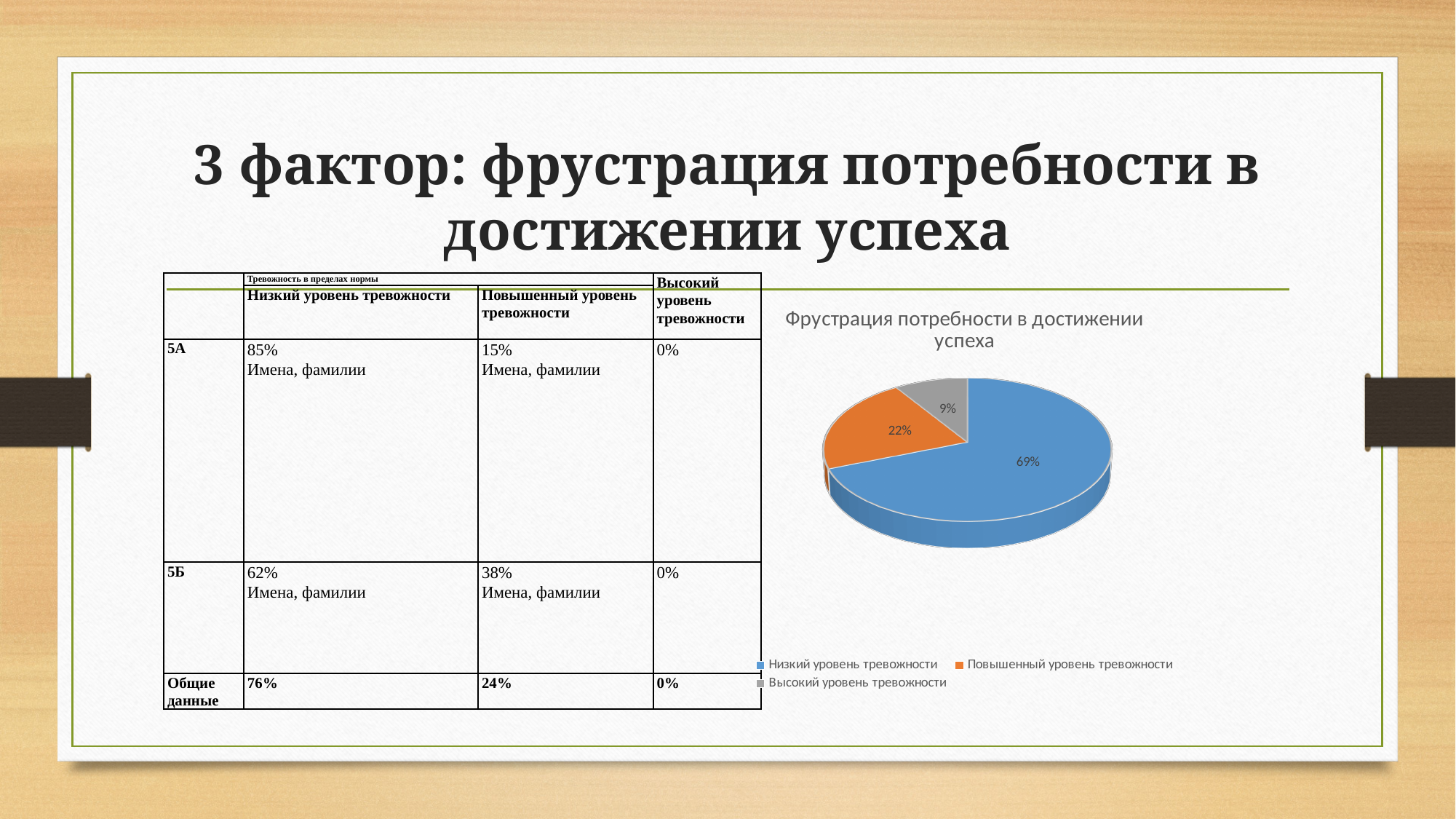
What is the difference in percentage points between the "Низкий уровень тревожности" slice and the "Повышенный уровень тревожности" slice? 47 Which slice is larger: "Повышенный уровень тревожности" or "Высокий уровень тревожности"? Повышенный уровень тревожности Which category has the largest slice in the pie chart? Низкий уровень тревожности What is the title of the pie chart? Фрустрация потребности в достижении успеха Which colour represents "Высокий уровень тревожности" in the pie chart? Grey What kind of chart is shown on the slide? Pie chart What share of the pie does "Повышенный уровень тревожности" take? 22% What share of the pie does "Низкий уровень тревожности" take? 69% How many slices does the pie chart have? 3 What share of the pie does "Высокий уровень тревожности" take? 9% How many entries does the legend of the pie chart list? 3 Which category has the smallest slice in the pie chart? Высокий уровень тревожности